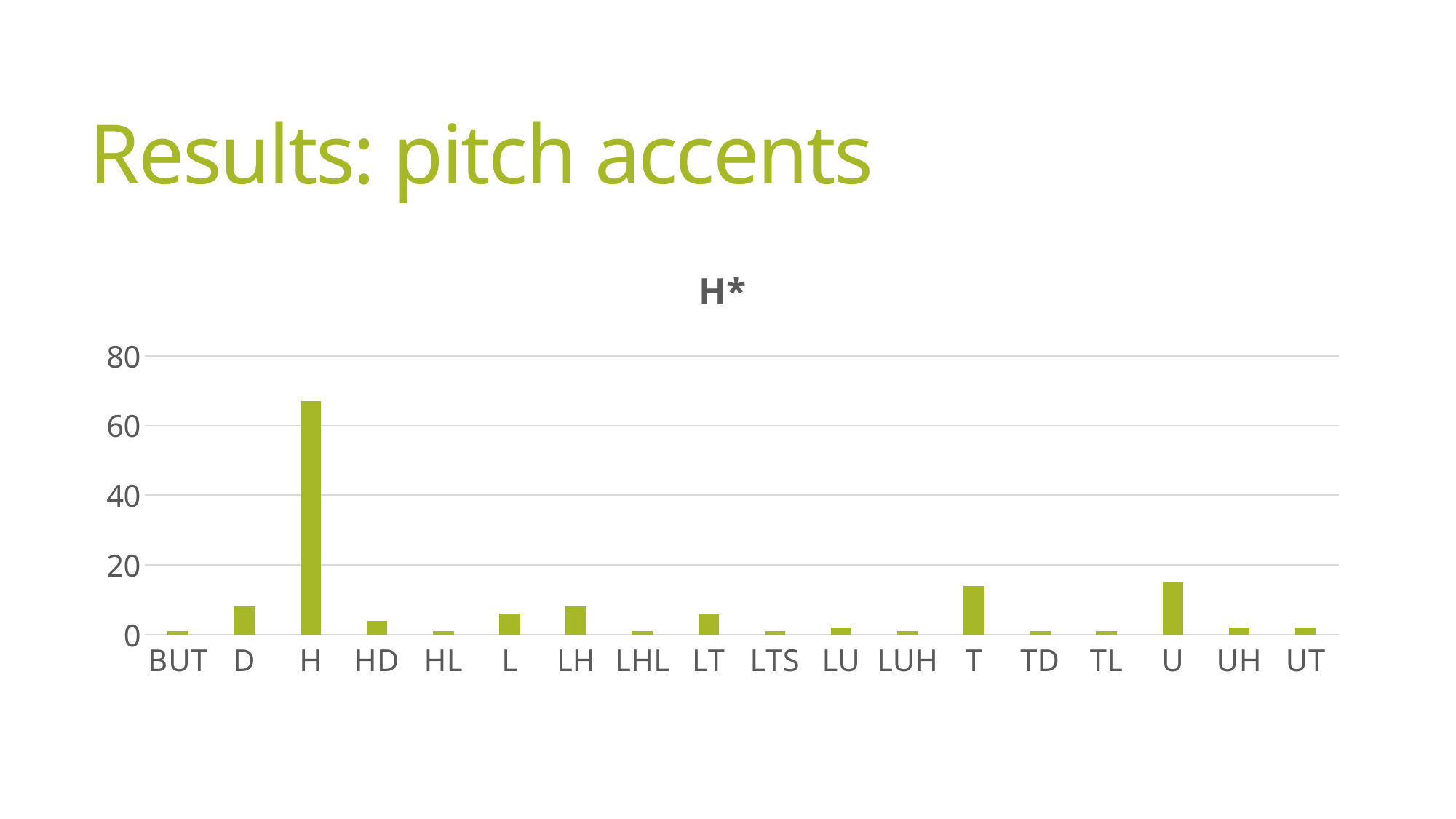
Which is larger, the value for T or the value for HD? T Is the value for U greater or less than 20? less Is the value for D greater or less than 20? less What is the title of the chart? H* Which is larger, the value for H or the value for U? H Is the value for H greater or less than 60? greater Which category has the highest value in the chart? H Which is larger, the value for U or the value for D? U How many categories are shown on the x axis of the chart? 18 What kind of chart is shown on the slide? bar chart